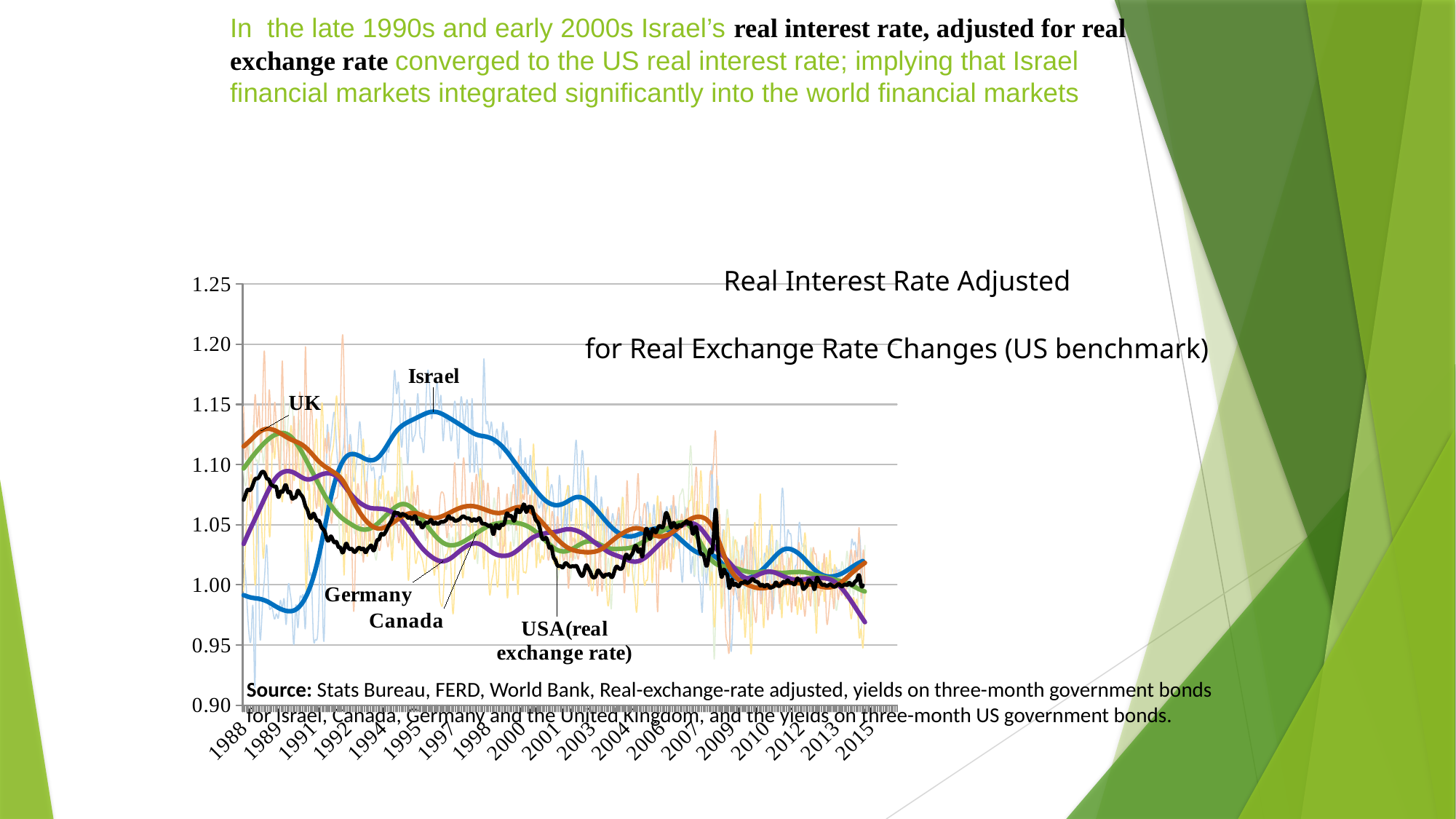
Is the peak of the Israel line around 1995 greater or less than 1.10? greater What is the highest value shown on the y axis? 1.25 How many countries/series are labeled on the chart? 5 Which series has the highest value around 1995? Israel Which series is labeled as the US benchmark line? USA(real exchange rate) Which series has the lowest value at the end of the chart (2015)? Germany What kind of chart is shown on the slide? line chart What is the title of the chart? Real Interest Rate Adjusted for Real Exchange Rate Changes (US benchmark) Is the value of the Israel line at the start of the chart (1988) greater or less than 1.05? less Around 1995, which is higher: the Israel line or the USA line? Israel Does the Israel line rise or fall between 1995 and 2009? fall